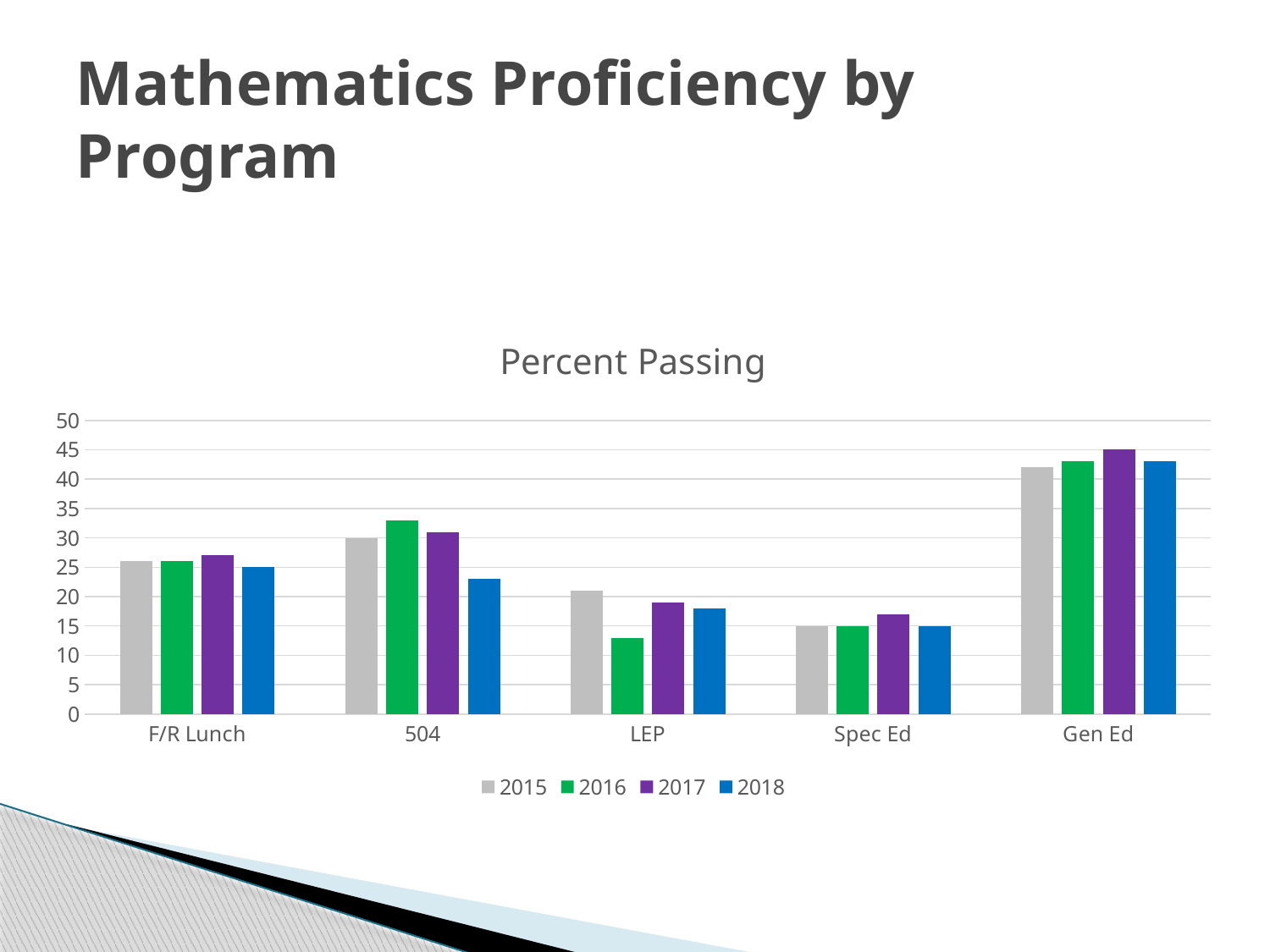
What is the title of the chart? Percent Passing What is the 2017 percent passing for Gen Ed? 45 How many series does the legend list? 4 Which program has the lowest percent passing for 2016? LEP Which program has the highest percent passing for 2017? Gen Ed What kind of chart is shown on the slide? bar chart For 504, which year has the larger value, 2016 or 2018? 2016 Is the 2015 value for Gen Ed greater or less than 40? greater For F/R Lunch, which year has the larger value, 2017 or 2018? 2017 What is the 2015 percent passing for Spec Ed? 15 Is the 2016 value for LEP greater or less than 15? less How many program categories are shown on the x axis? 5